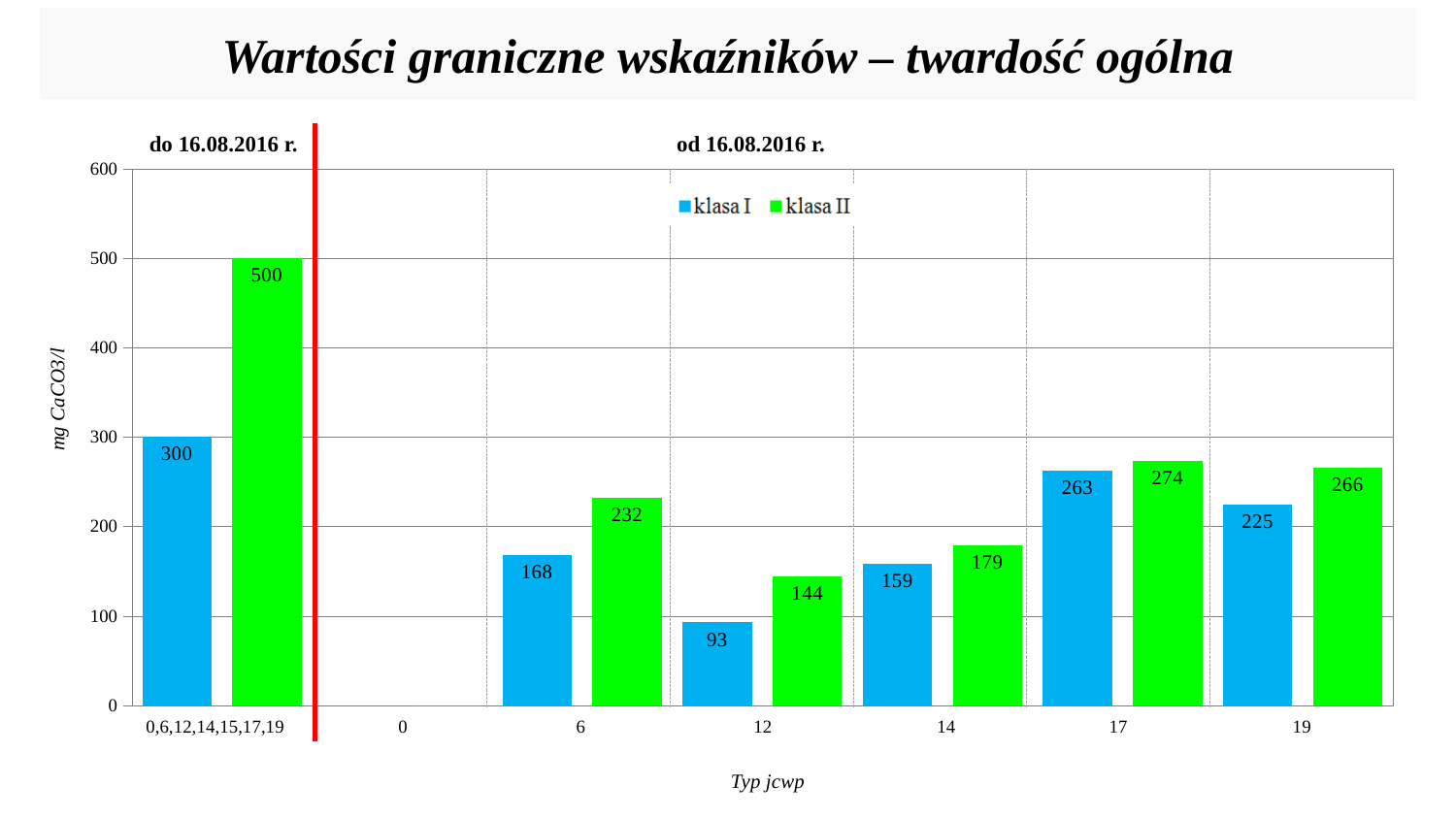
Which category has the highest klasa II value? 0,6,12,14,15,17,19 What is the klasa II value for Typ jcwp 12? 144 Is the klasa I value for Typ jcwp 14 greater or less than 200? less How many series does the legend list? 2 What is the klasa I value for Typ jcwp 6? 168 What is the klasa II value for the category labelled 0,6,12,14,15,17,19? 500 Which is larger for Typ jcwp 19: the klasa I value or the klasa II value? klasa II What is the difference between the klasa II and klasa I values for Typ jcwp 17? 11 What is the label of the y axis? mg CaCO3/l What is the difference between the klasa II value for Typ jcwp 6 and the klasa II value for Typ jcwp 12? 88 What kind of chart is shown on the slide? bar chart